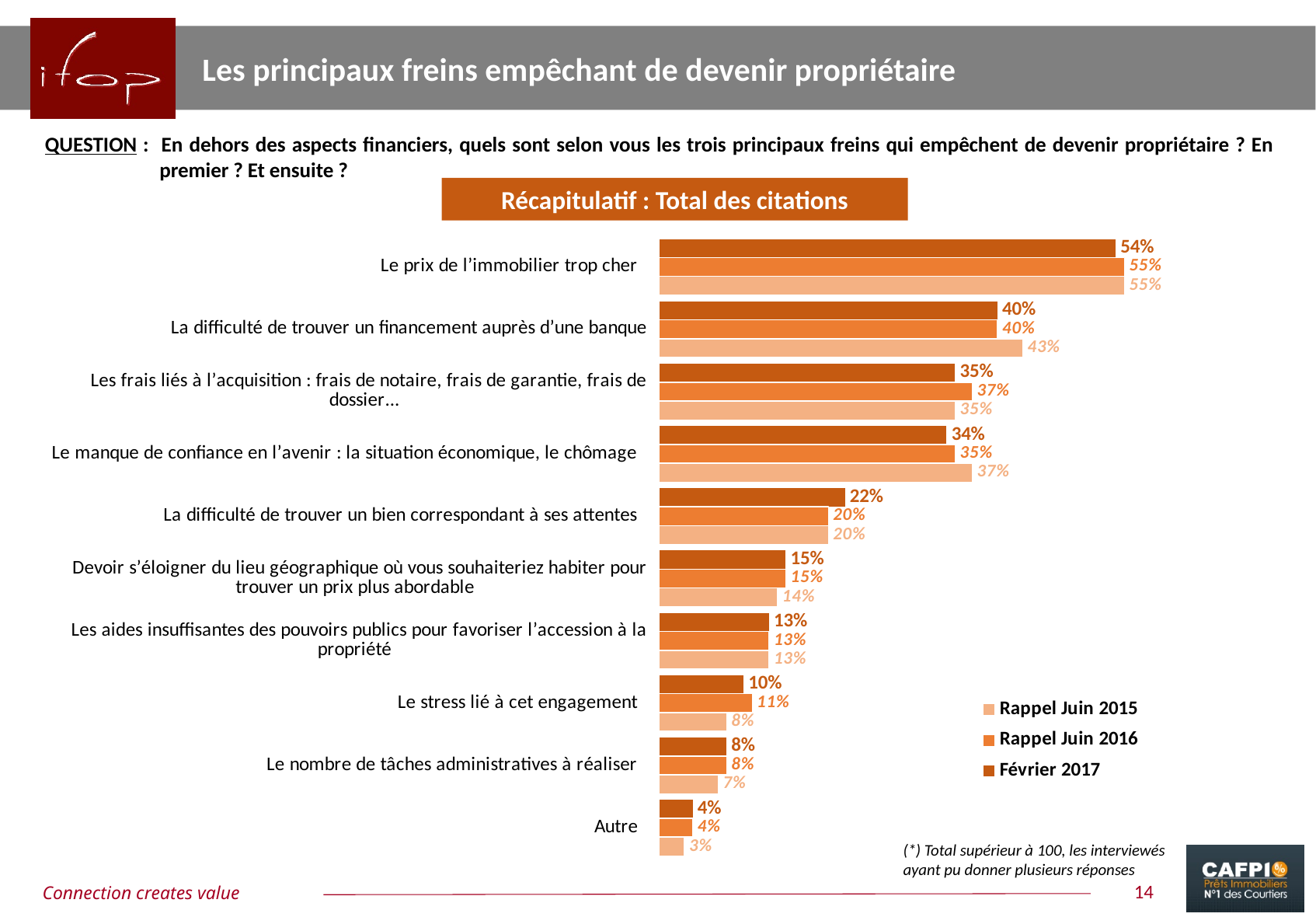
What is the Février 2017 value for "Le prix de l'immobilier trop cher"? 54% What is the difference between the Rappel Juin 2015 and Février 2017 values for "Le manque de confiance en l'avenir : la situation économique, le chômage"? 3 percentage points What is the Rappel Juin 2016 value for "Le stress lié à cet engagement"? 11% For "La difficulté de trouver un bien correspondant à ses attentes", which is larger: the Février 2017 value or the Rappel Juin 2016 value? Février 2017 What is the Rappel Juin 2015 value for "La difficulté de trouver un financement auprès d'une banque"? 43% Which category has the lowest Rappel Juin 2015 value? Autre What kind of chart is shown on the slide? Bar chart What is the title shown above the chart? Récapitulatif : Total des citations Which category has the highest Février 2017 value? Le prix de l'immobilier trop cher How many categories (freins) are plotted in the chart? 10 What is the Février 2017 value for "Le nombre de tâches administratives à réaliser"? 8% How many series does the legend list? 3